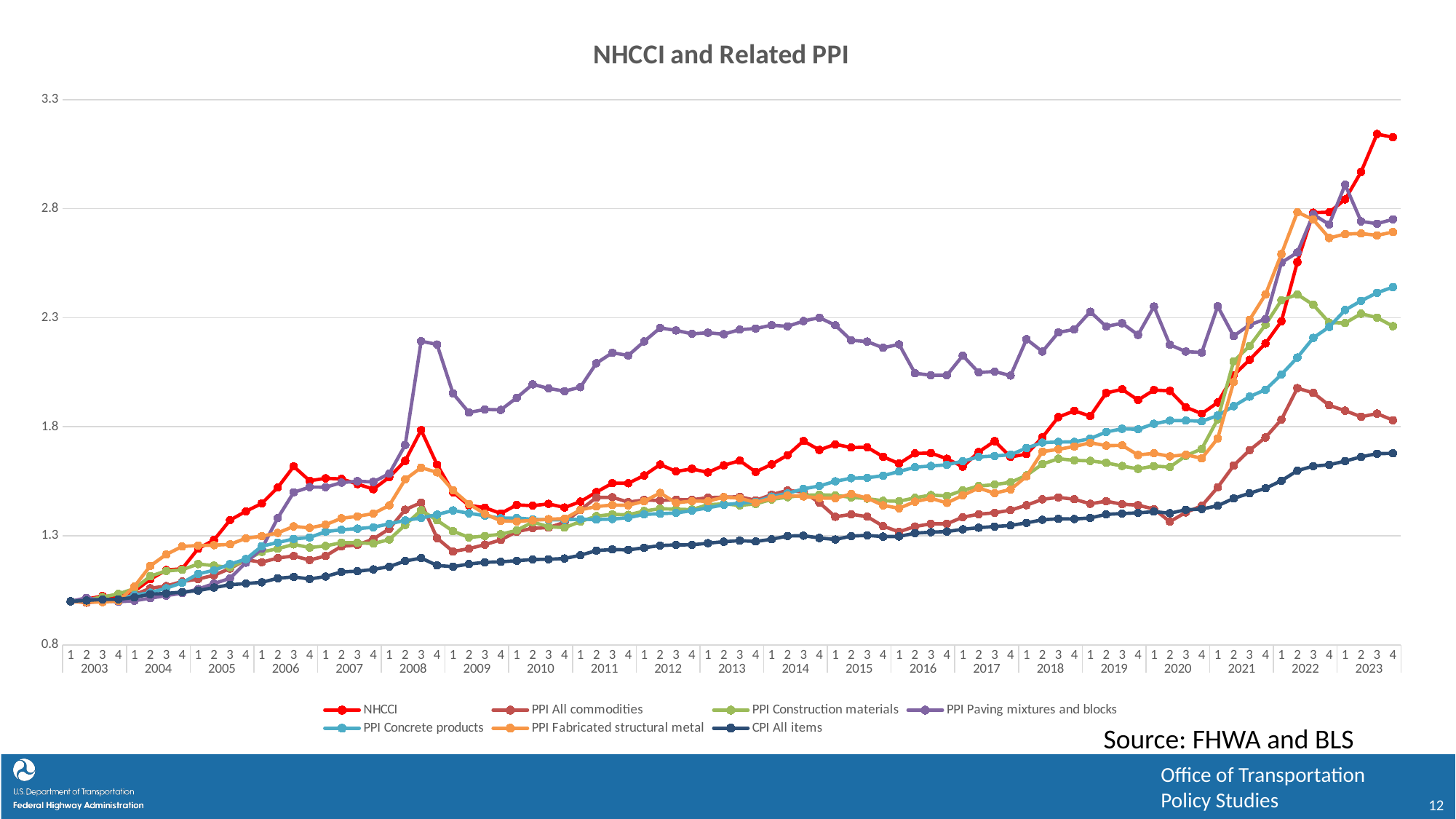
Which series reaches the highest value during 2008? PPI Paving mixtures and blocks Is the PPI All commodities value at quarter 4 of 2023 greater or less than 2.3? less Is the NHCCI value at quarter 4 of 2023 greater or less than 2.8? greater Is the CPI All items value at quarter 4 of 2023 greater or less than 1.8? less Which series has the lowest value at quarter 4 of 2023? CPI All items How many series does the legend list? 7 Does the CPI All items series generally rise or fall from 2003 to 2023? Rise At quarter 4 of 2023, which is larger: PPI Concrete products or PPI Construction materials? PPI Concrete products What is the title of the chart? NHCCI and Related PPI Which series has the highest value at quarter 4 of 2023? NHCCI What kind of chart is shown on the slide? Line chart